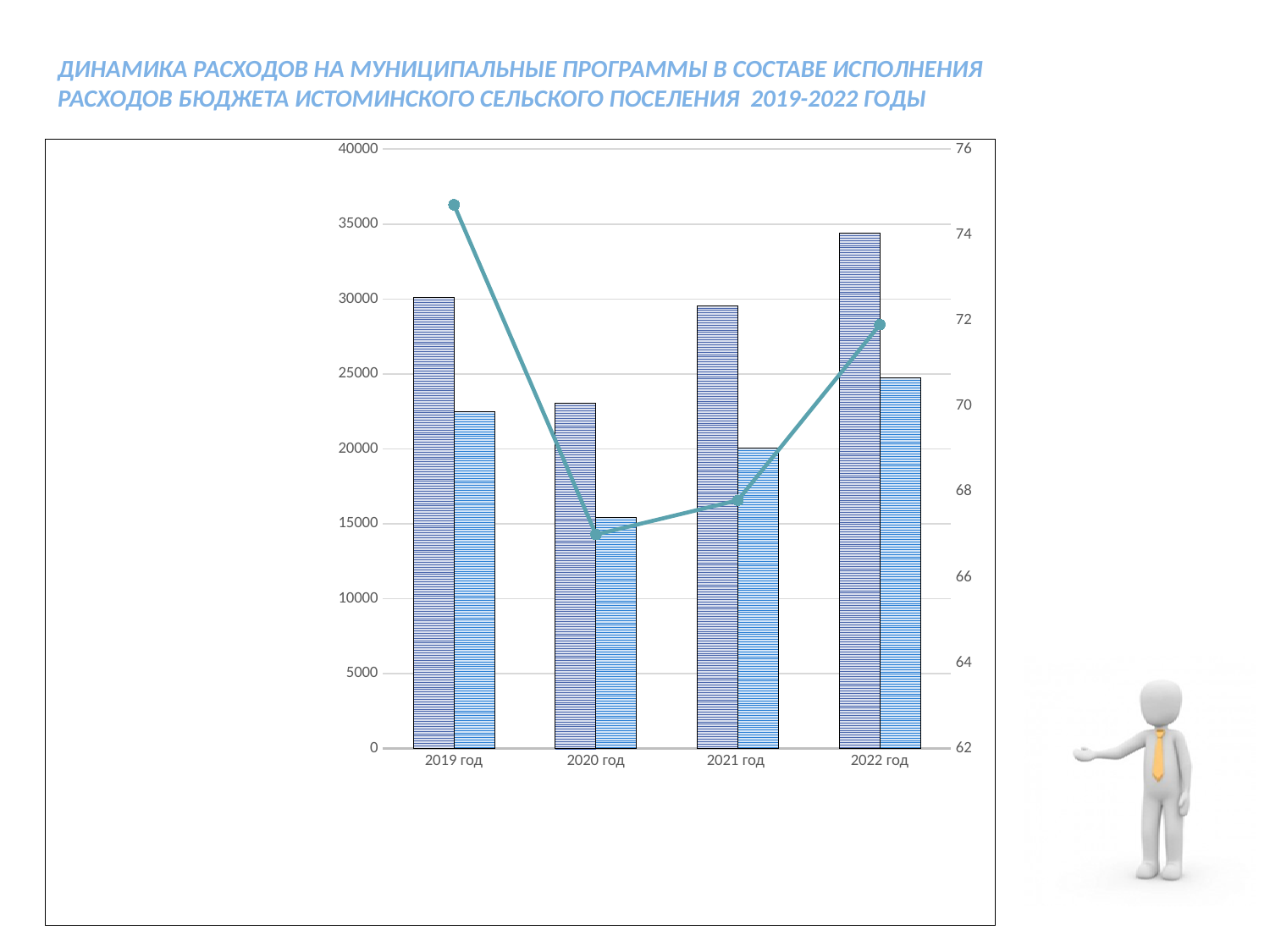
Is the value of the left (darker) bar for 2020 год greater or less than 25000? less Does the line rise or fall from 2019 год to 2020 год? fall Which is larger, the left (darker) bar for 2019 год or the left (darker) bar for 2020 год? 2019 год In which year is the left (darker) bar the shortest? 2020 год Is the value of the left (darker) bar for 2022 год greater or less than 30000? greater What kind of chart is shown on the slide? A bar chart combined with a line In which year is the left (darker) bar the tallest? 2022 год On the right-hand axis, is the line value for 2020 год greater or less than 68? less In which year is the right (lighter) bar the shortest? 2020 год In which year does the line reach its highest point? 2019 год How many year categories are shown on the x axis of the chart? 4